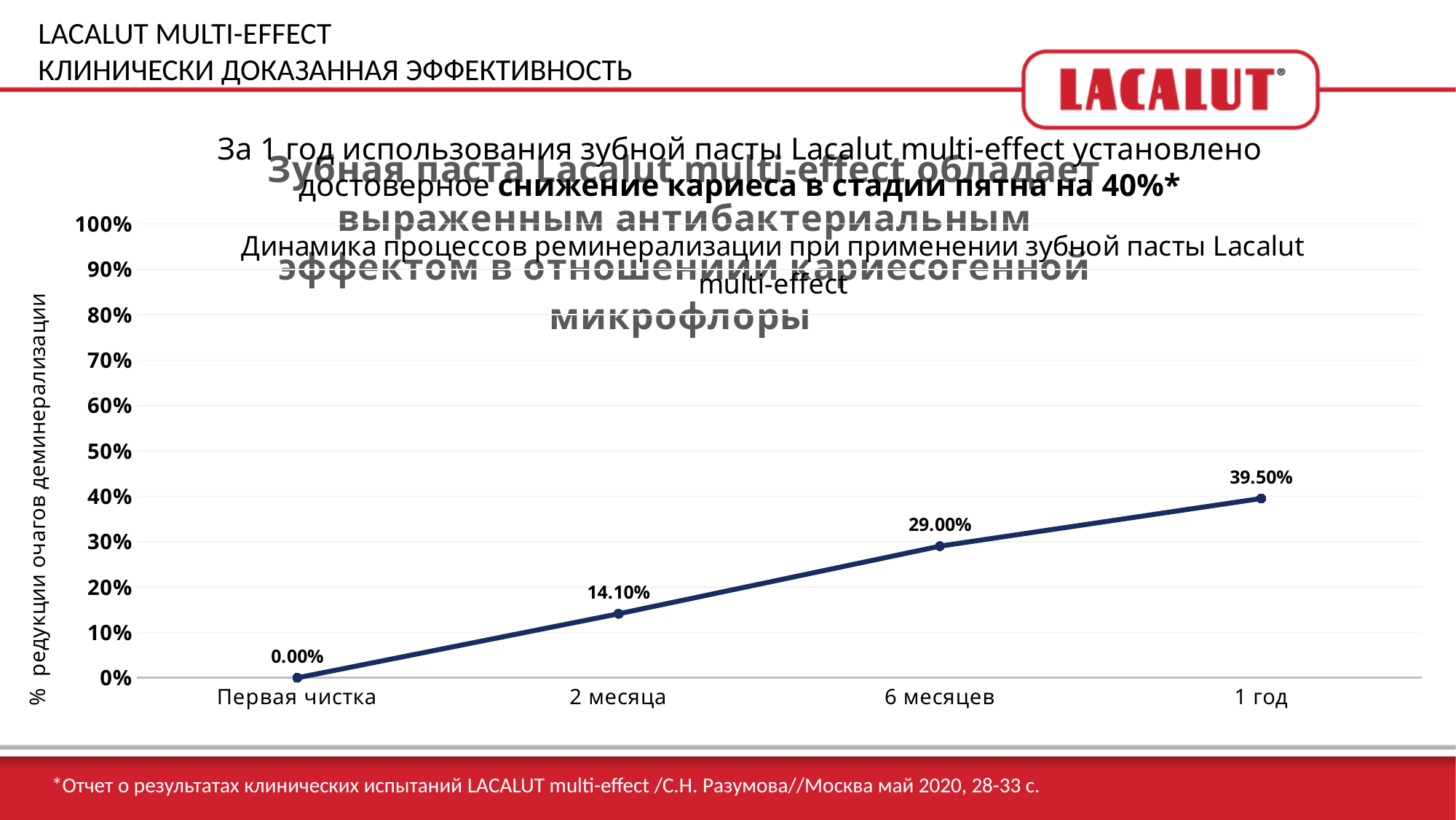
What is the value for 1 год? 39.50% What is the difference between the values for 6 месяцев and 2 месяца? 14.90% How many data points are plotted on the chart? 4 What kind of chart is shown on the slide? Line chart What is the difference between the values for 1 год and 6 месяцев? 10.50% Which category has the highest value? 1 год What is the value for 6 месяцев? 29.00% Which is larger, the value for 2 месяца or the value for 6 месяцев? 6 месяцев Do the values rise or fall along the x axis from Первая чистка to 1 год? Rise What is the value for Первая чистка? 0.00% What is the value for 2 месяца? 14.10% Which category has the lowest value? Первая чистка